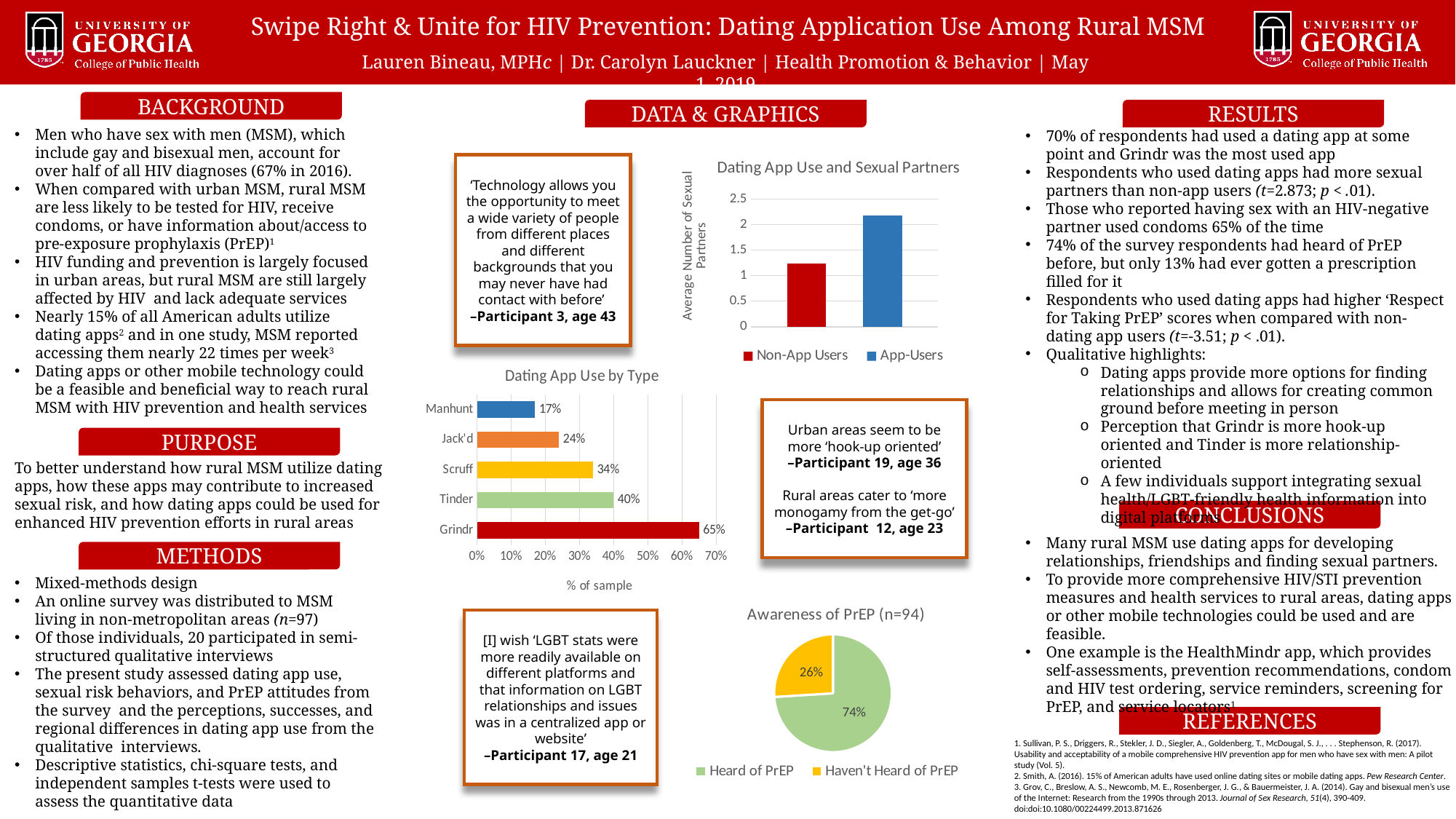
How many series does the legend of the 'Awareness of PrEP (n=94)' chart list? 2 In the 'Dating App Use by Type' chart, what percentage of the sample used Grindr? 65% In the 'Dating App Use and Sexual Partners' chart, which group has the higher average number of sexual partners, Non-App Users or App-Users? App-Users In the 'Dating App Use by Type' chart, which app has the lowest percentage? Manhunt In the 'Dating App Use by Type' chart, which app has the highest percentage? Grindr In the 'Dating App Use and Sexual Partners' chart, is the value for App-Users greater or less than 2? greater In the 'Dating App Use by Type' chart, how many apps are listed? 5 What kind of chart is 'Dating App Use by Type'? Bar chart In the 'Dating App Use by Type' chart, what is the value for Scruff? 34% In the 'Awareness of PrEP (n=94)' pie chart, what share of respondents had heard of PrEP? 74% In the 'Dating App Use and Sexual Partners' chart, is the value for Non-App Users greater or less than 1.5? less In the 'Dating App Use by Type' chart, what is the difference between the Tinder and Jack'd percentages? 16%